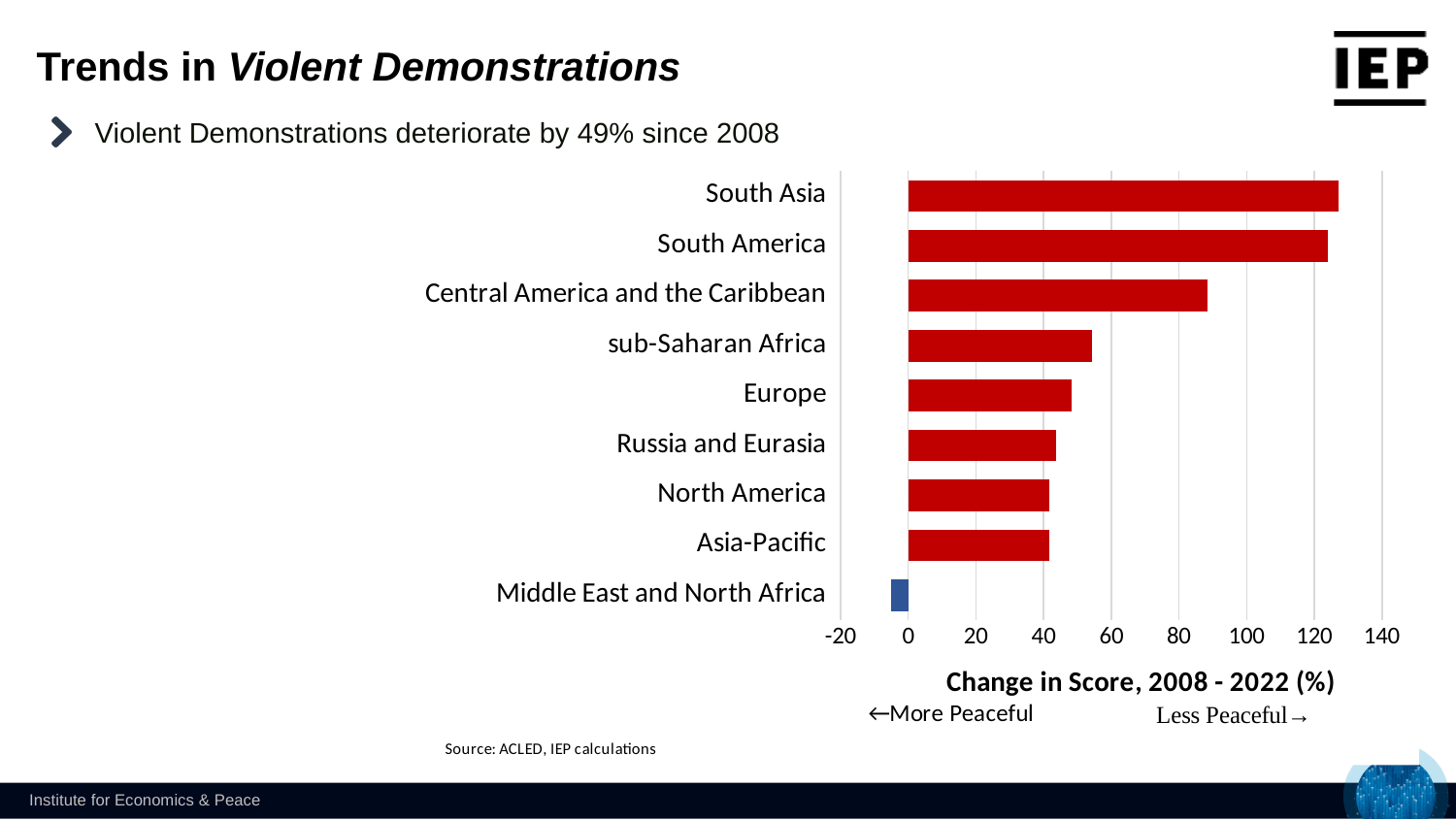
Is the value for Central America and the Caribbean greater or less than 80? greater Is the value for Europe greater or less than 40? greater Which region has the lowest change in score in the chart? Middle East and North Africa Is the value for South Asia greater or less than 120? greater Which region's bar is coloured blue rather than red? Middle East and North Africa What is the title of the horizontal axis of the chart? Change in Score, 2008 - 2022 (%) Which has the larger change in score, South America or Europe? South America Which has the larger change in score, Central America and the Caribbean or sub-Saharan Africa? Central America and the Caribbean How many regions are plotted in the chart? 9 What kind of chart is shown on the slide? bar chart